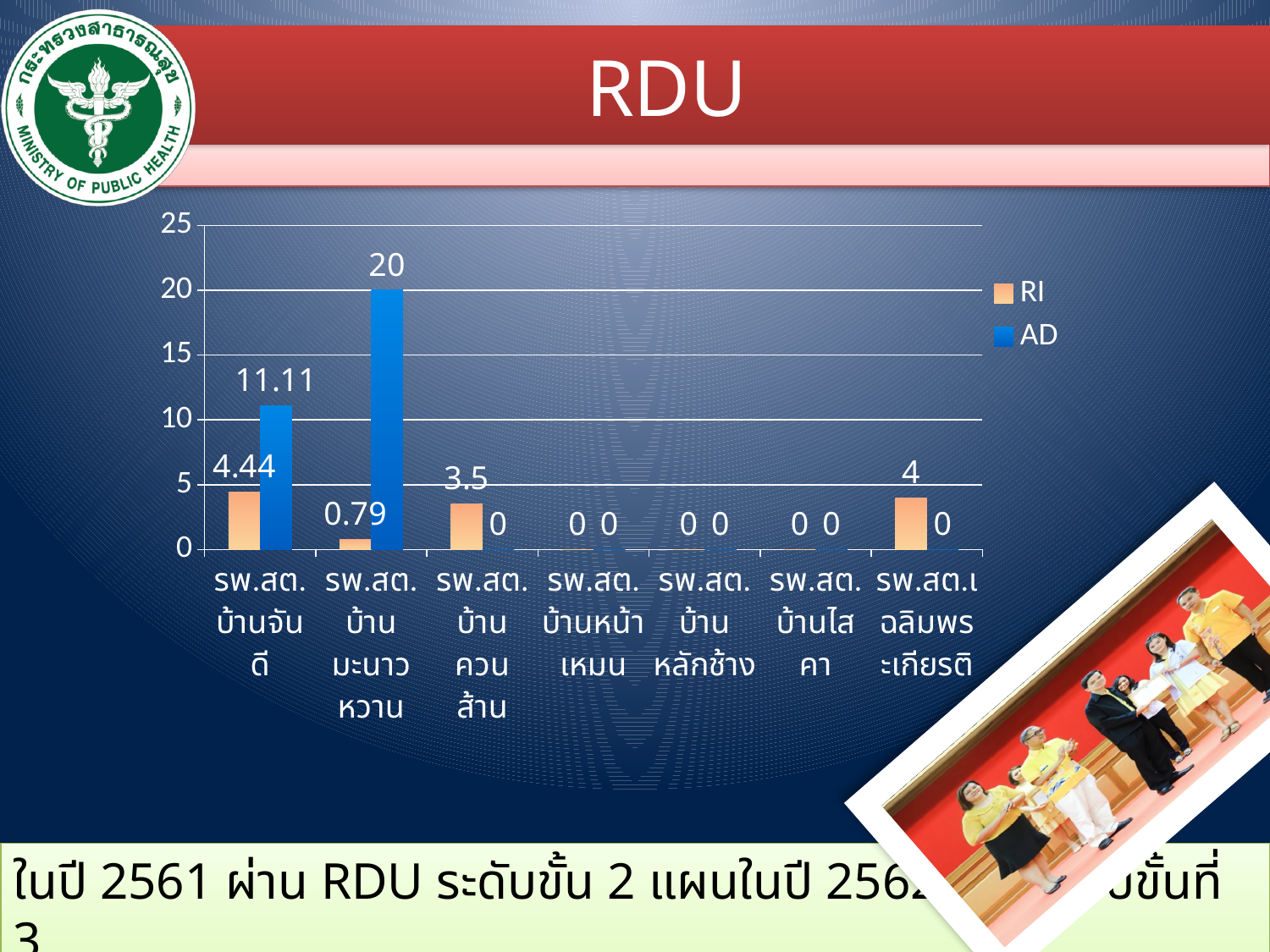
What is the AD value for รพ.สต.บ้านมะนาวหวาน? 20 What type of chart is shown on the slide? bar chart What is the RI value for รพ.สต.บ้านควนส้าน? 3.5 Which is larger, the RI value for รพ.สต.บ้านจันดี or the RI value for รพ.สต.เฉลิมพระเกียรติ? รพ.สต.บ้านจันดี What is the RI value for รพ.สต.บ้านจันดี? 4.44 What is the difference between the AD values for รพ.สต.บ้านมะนาวหวาน and รพ.สต.บ้านจันดี? 8.89 Which category has the highest RI value? รพ.สต.บ้านจันดี How many categories are shown on the x axis? 7 What is the AD value for รพ.สต.บ้านจันดี? 11.11 What is the RI value for รพ.สต.เฉลิมพระเกียรติ? 4 Which category has the highest AD value? รพ.สต.บ้านมะนาวหวาน How many series does the legend list? 2